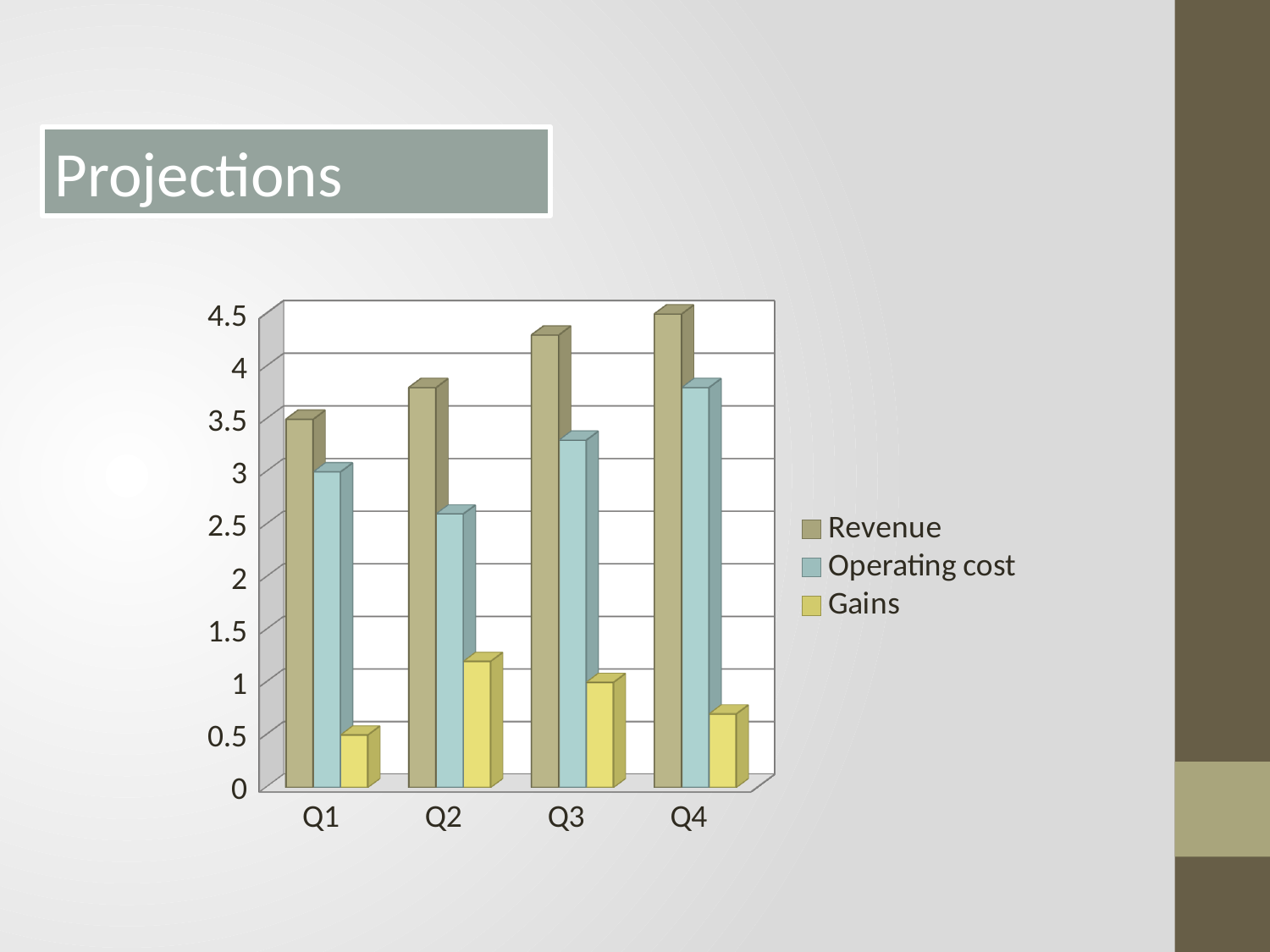
Is the Operating cost value for Q2 greater or less than 3? less Is the Revenue value for Q1 greater or less than 4? less In Q1, which is larger, Revenue or Operating cost? Revenue Is the Gains value for Q1 greater or less than 1? less In which quarter is Operating cost lowest? Q2 How many quarters are shown on the x axis? 4 In which quarter is Revenue highest? Q4 How many series does the legend list? 3 Does Revenue rise or fall from Q1 to Q4? rise In which quarter is Gains lowest? Q1 What kind of chart is shown on the slide? bar chart